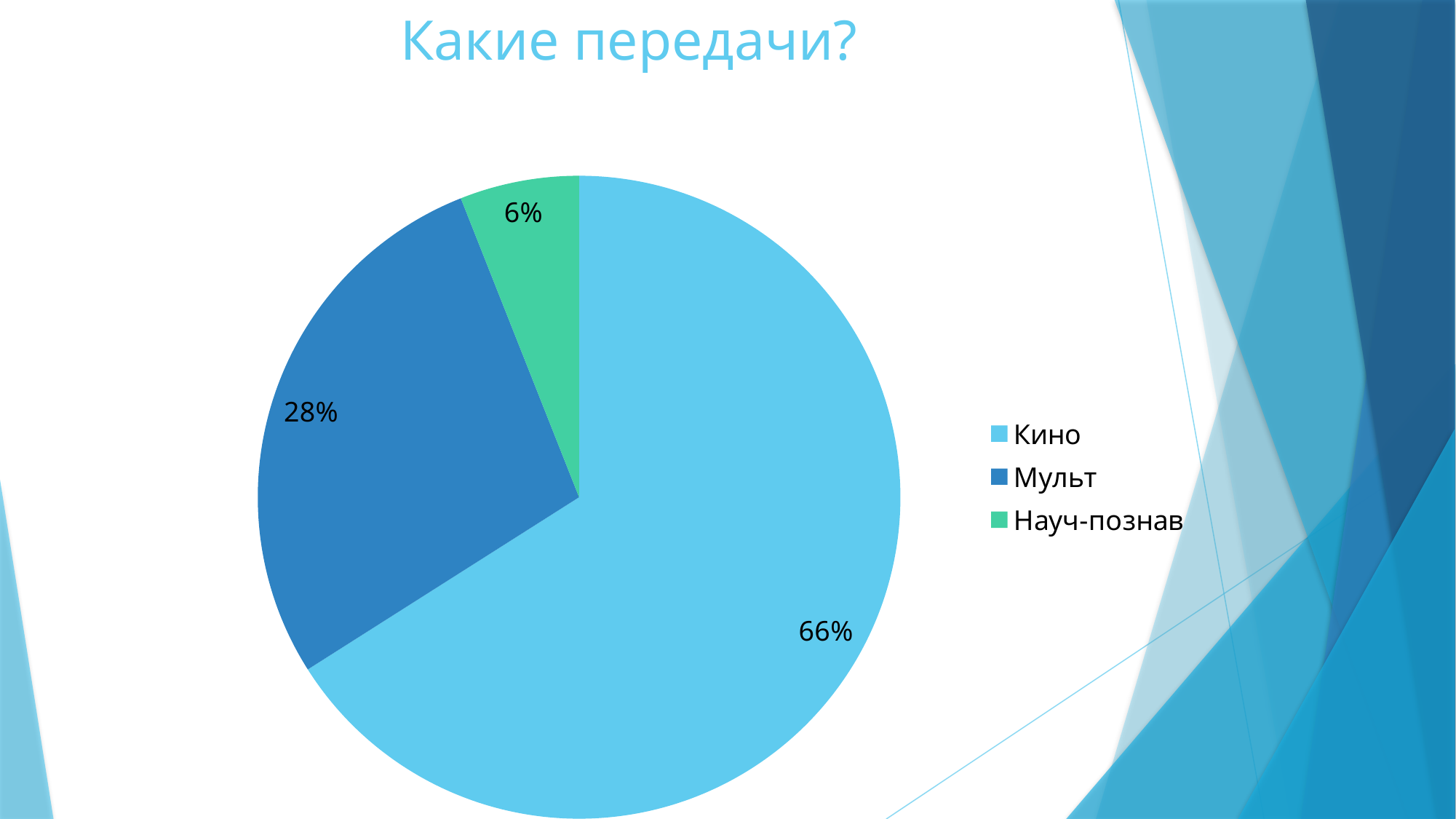
Which category has the smallest slice of the pie? Науч-познав What is the difference between the shares of Кино and Мульт? 38% What is the difference between the shares of Мульт and Науч-познав? 22% What share of the pie does Кино have? 66% Which is larger, the share for Мульт or the share for Науч-познав? Мульт How many slices does the pie chart have? 3 Which category has the largest slice of the pie? Кино Which category is shown in green in the legend? Науч-познав What share of the pie does Мульт have? 28% What share of the pie does Науч-познав have? 6% What kind of chart is shown on the slide? pie chart What is the title of the chart on the slide? Какие передачи?